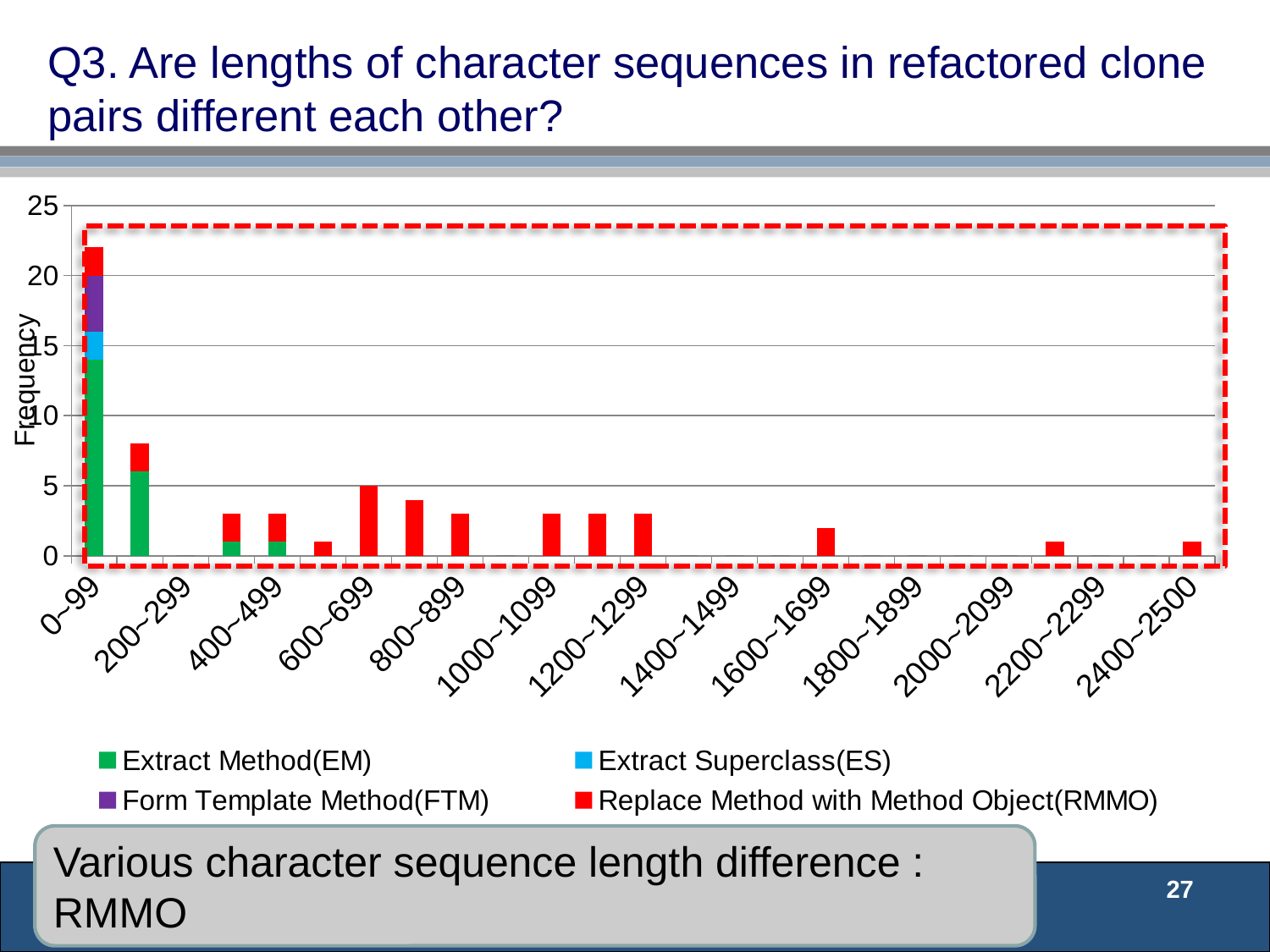
Is the frequency for 600~699 greater or less than 10? less How many series does the legend list? 4 Which has the larger frequency, 800~899 or 1600~1699? 800~899 Which has the larger total frequency, 0~99 or 600~699? 0~99 What kind of chart is shown on the slide? bar chart What is the label of the vertical axis? Frequency Is the frequency for 1600~1699 greater or less than 5? less Is the frequency for 2400~2500 greater or less than 5? less What is the frequency for 600~699? 5 Which category has the highest total frequency? 0~99 Which series is shown in green in the legend? Extract Method(EM)